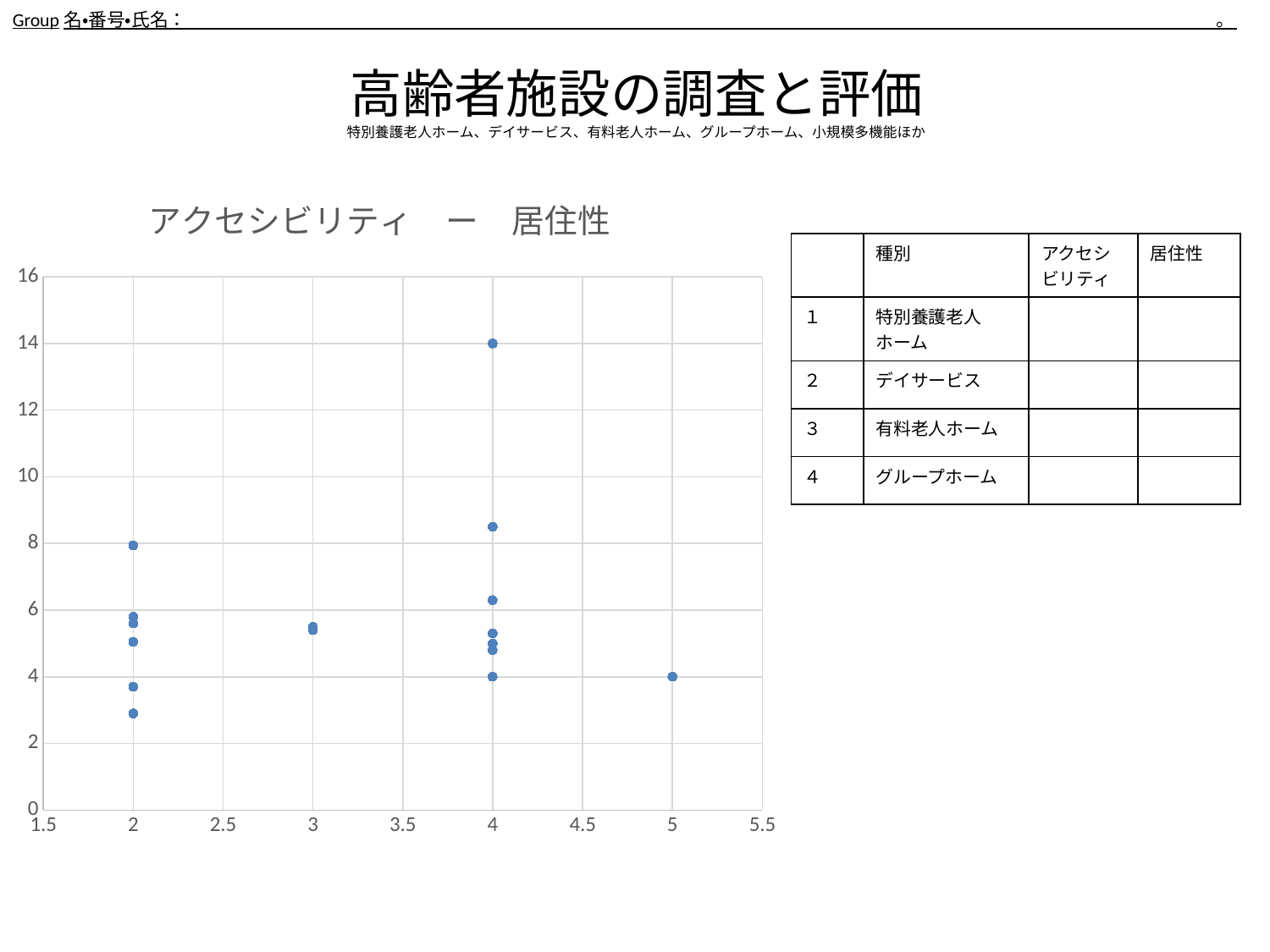
Is the y value of the highest point at x = 2 greater or less than 6? greater What is the highest value shown on the y axis of the chart? 16 What kind of chart is shown on the slide? scatter chart What is the title of the chart? アクセシビリティ ー 居住性 What is the y value of the point at x = 5? 4 At which x value is the lowest point on the chart located? 2 On how many distinct x values do the plotted points fall? 4 At which x value is the highest point on the chart located? 4 Is the y value of the point at x = 3 greater or less than 4? greater Is the y value of the point at x = 5 greater or less than 6? less What is the y value of the highest point on the chart? 14